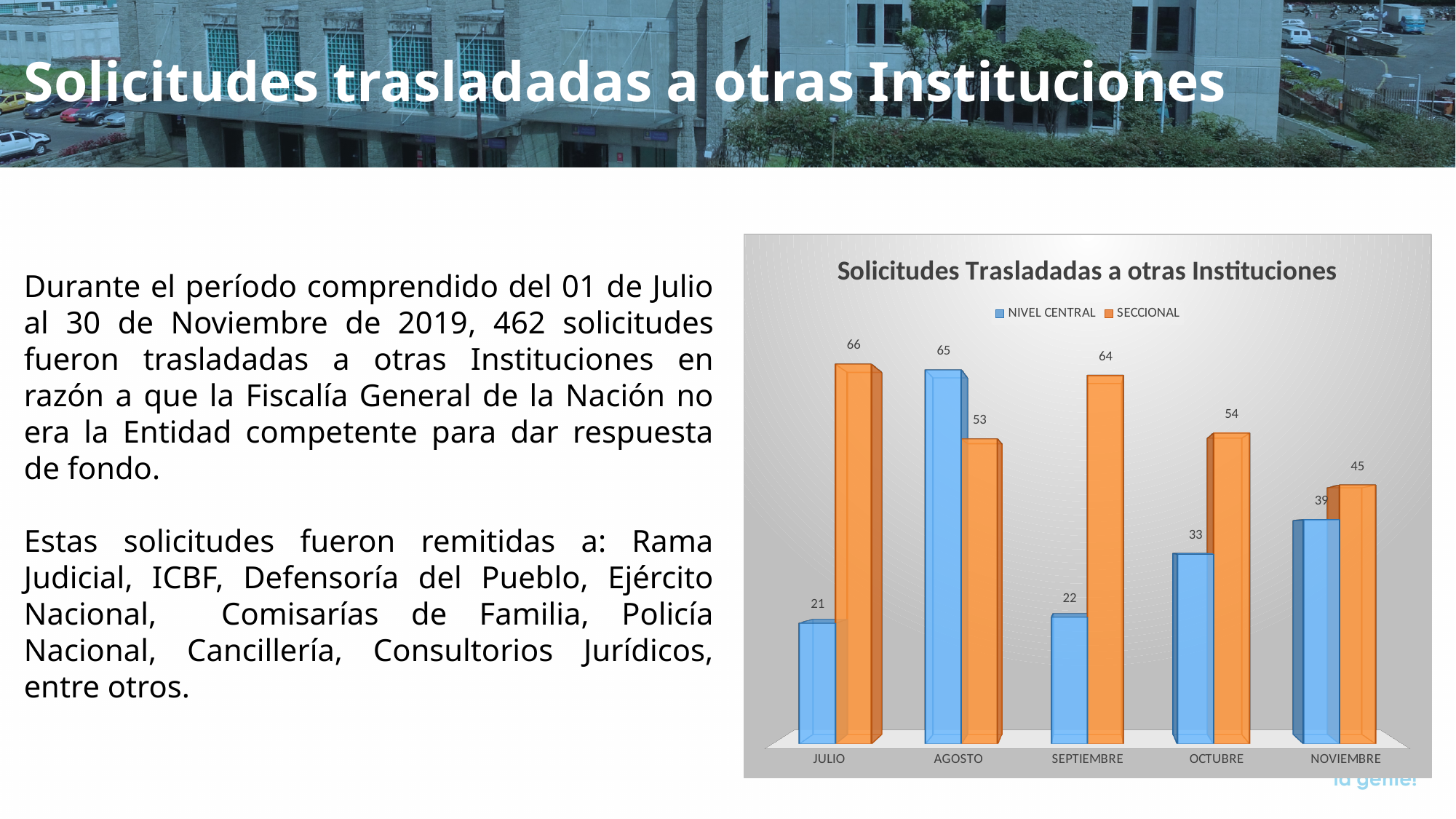
Which month has the lowest NIVEL CENTRAL value? JULIO How many months are shown on the x axis? 5 What kind of chart is shown? Bar chart Which is larger for AGOSTO, NIVEL CENTRAL or SECCIONAL? NIVEL CENTRAL What is the title of the chart? Solicitudes Trasladadas a otras Instituciones How many series does the legend list? 2 What is the SECCIONAL value for SEPTIEMBRE? 64 What is the NIVEL CENTRAL value for JULIO? 21 What is the NIVEL CENTRAL value for NOVIEMBRE? 39 What is the difference between the SECCIONAL and NIVEL CENTRAL values for OCTUBRE? 21 Which month has the highest SECCIONAL value? JULIO Does the SECCIONAL series rise or fall from JULIO to NOVIEMBRE? Fall